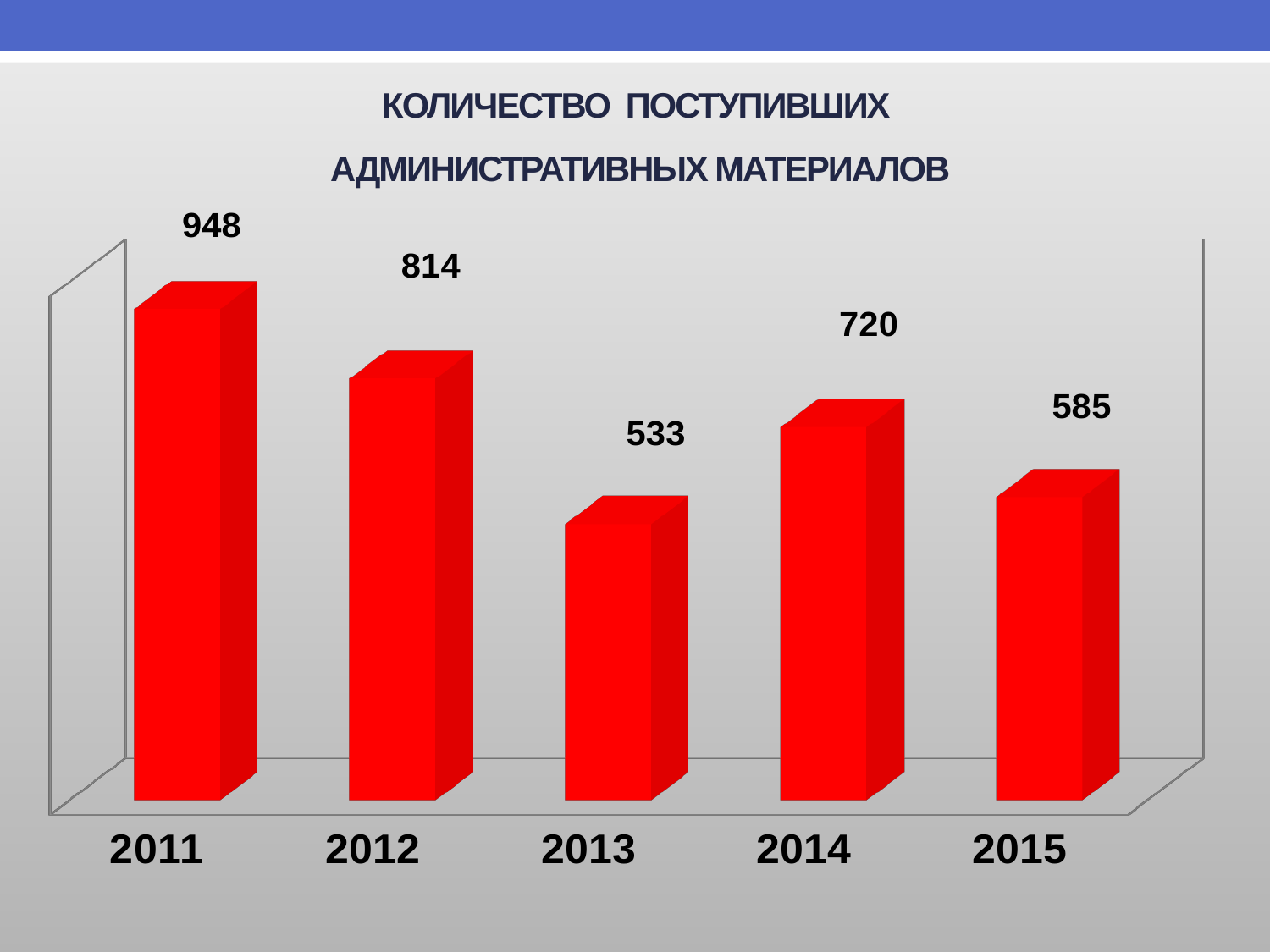
Which is larger, the value for 2012 or the value for 2014? 2012 What is the difference between the values for 2011 and 2012? 134 What is the value for 2013? 533 Which year has the highest value? 2011 What is the value for 2015? 585 Which year has the lowest value? 2013 What colour are the bars? red What kind of chart is this? bar chart Do the values rise or fall from 2011 to 2013? fall How many years are shown on the chart? 5 What is the value for 2011? 948 What is the difference between the values for 2014 and 2015? 135